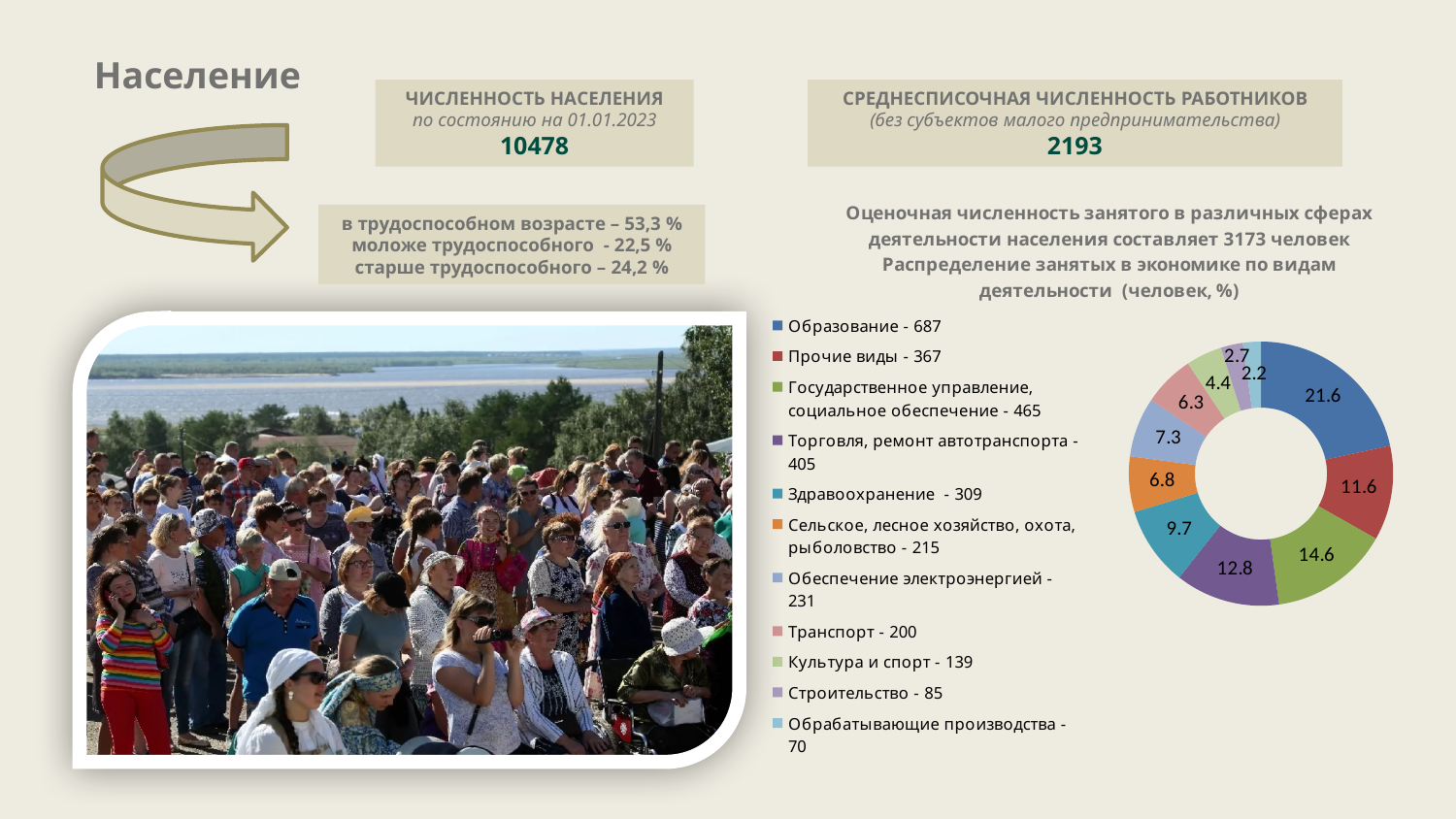
What colour is the slice for Образование in the doughnut chart? Blue What percentage share does the doughnut chart show for Торговля, ремонт автотранспорта? 12.8 Which has a larger share in the doughnut chart: Государственное управление, социальное обеспечение or Прочие виды? Государственное управление, социальное обеспечение What percentage share does the doughnut chart show for Образование? 21.6 According to the legend, how many people are employed in Сельское, лесное хозяйство, охота, рыболовство? 215 How many categories does the doughnut chart's legend list? 11 What kind of chart is shown on the slide? Doughnut (pie) chart What is the difference in percentage points between the shares of Образование (21.6) and Прочие виды (11.6)? 10 What percentage share does the doughnut chart show for Здравоохранение? 9.7 Which category has the smallest share in the doughnut chart? Обрабатывающие производства According to the legend, how many people are employed in Транспорт? 200 Which category has the largest share in the doughnut chart? Образование